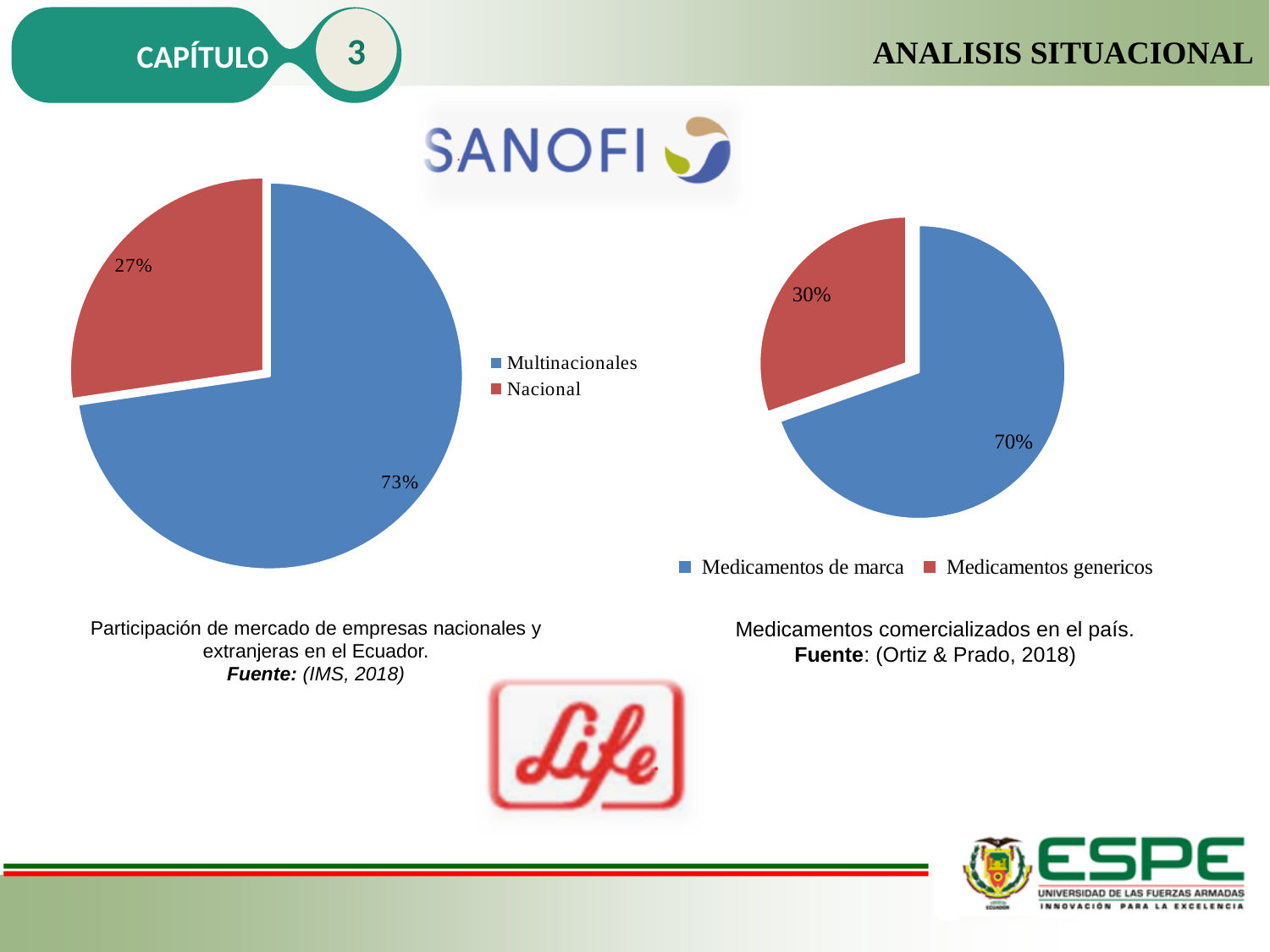
In the left pie chart, what is the difference between the Multinacionales and Nacional shares? 46% In the right pie chart, which is larger, Medicamentos de marca or Medicamentos genericos? Medicamentos de marca In the left pie chart, which category has the largest share? Multinacionales What kind of chart is the left chart on the slide? Pie chart In the left pie chart, what colour is the Nacional slice? Red In the right pie chart, which category has the smallest share? Medicamentos genericos In the left pie chart, what is the value for Nacional? 27% In the right pie chart, what is the value for Medicamentos de marca? 70% How many categories does the legend of the right pie chart list? 2 In the right pie chart, what is the value for Medicamentos genericos? 30% In the left pie chart, what is the value for Multinacionales? 73% In the right pie chart, what is the difference between Medicamentos de marca and Medicamentos genericos? 40%